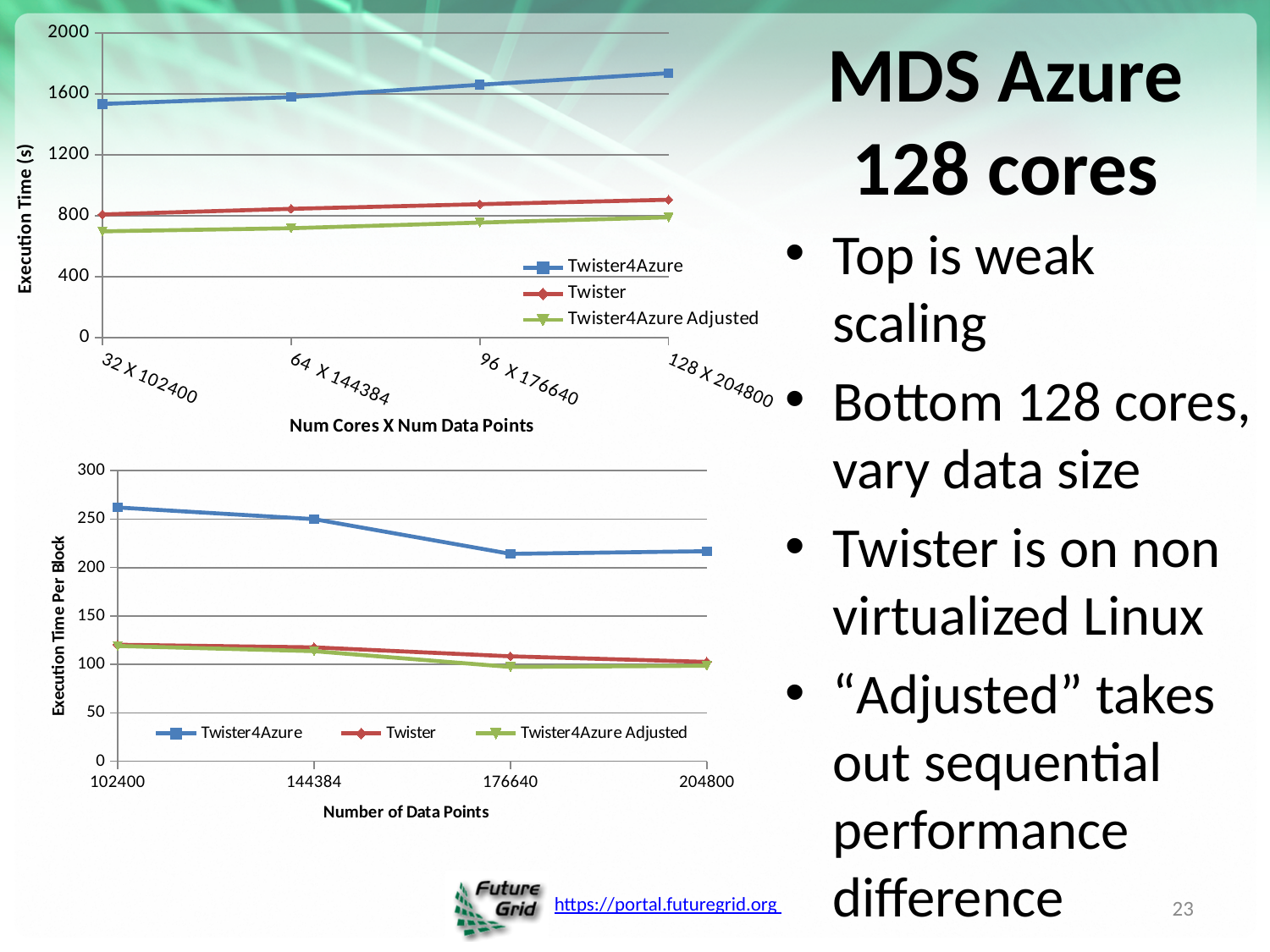
What kind of chart is the top chart on the slide? line chart In the top chart, does the Twister4Azure line rise or fall as the number of cores and data points increases? rise What is the x-axis title of the bottom chart? Number of Data Points In the bottom chart, is the Twister4Azure value at 102400 data points greater or less than 250? greater In the top chart, is the Twister4Azure Adjusted value at 32 X 102400 greater or less than 800? less In the bottom chart, which is larger at 144384 data points: Twister4Azure or Twister? Twister4Azure In the bottom chart, does the Twister4Azure line rise or fall as the number of data points increases? fall How many categories are shown on the x axis of the top chart? 4 In the top chart, is the Twister4Azure value at 32 X 102400 greater or less than 1200? greater How many series does the legend of the bottom chart list? 3 In the top chart, which series has the highest execution time at 128 X 204800? Twister4Azure